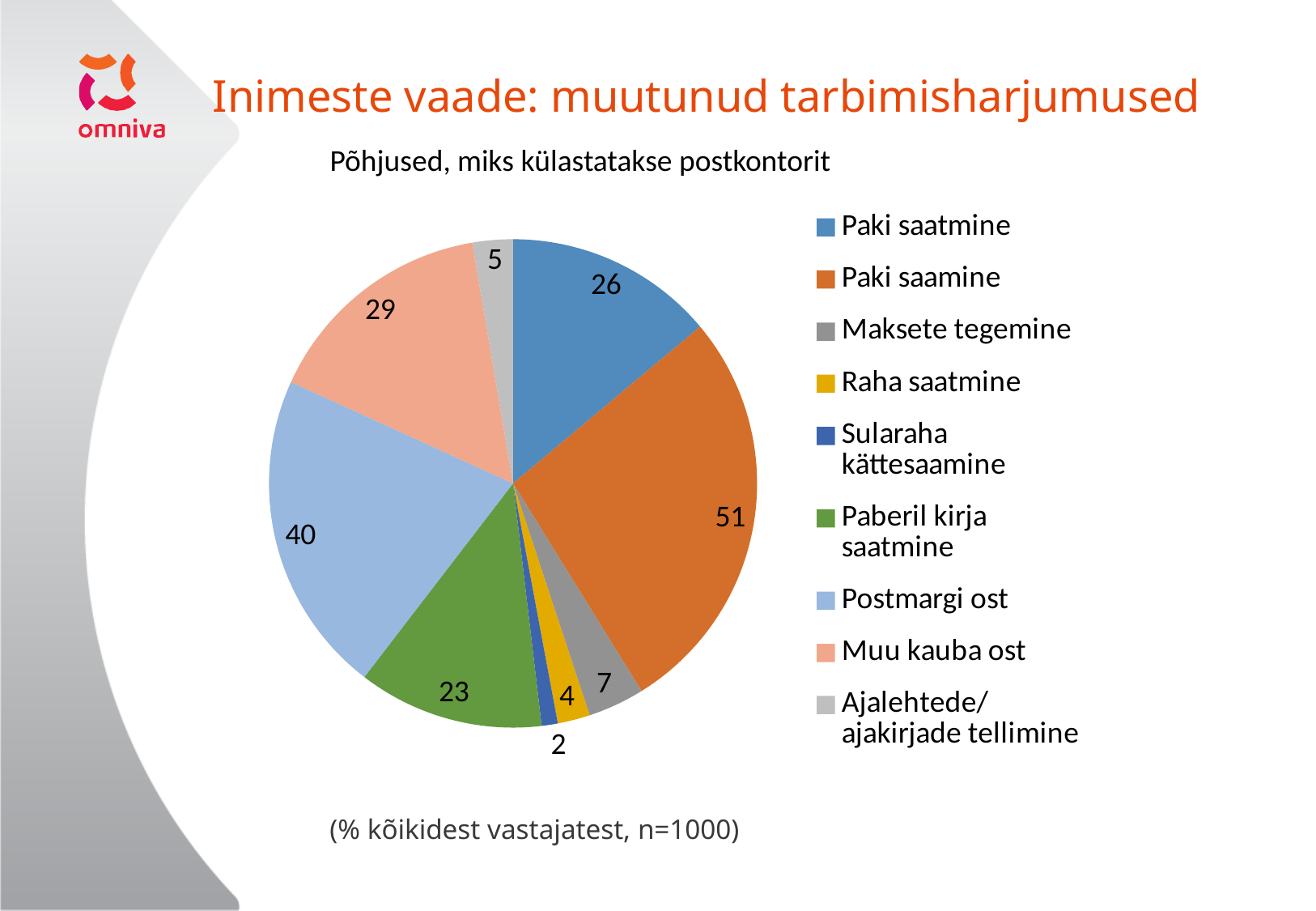
What is the value for Postmargi ost in the pie chart? 40 What is the difference between the values for Paki saamine and Paki saatmine? 25 Which category has the highest value in the pie chart? Paki saamine Which category has the lowest value in the pie chart? Sularaha kättesaamine Which is larger, the value for Paberil kirja saatmine or the value for Maksete tegemine? Paberil kirja saatmine What is the value for Sularaha kättesaamine in the pie chart? 2 What kind of chart is shown on the slide? Pie chart What is the difference between the values for Postmargi ost and Muu kauba ost? 11 What is the value for Paki saamine in the pie chart? 51 How many categories does the pie chart show? 9 What is the title of the chart? Põhjused, miks külastatakse postkontorit What is the value for Ajalehtede/ajakirjade tellimine in the pie chart? 5